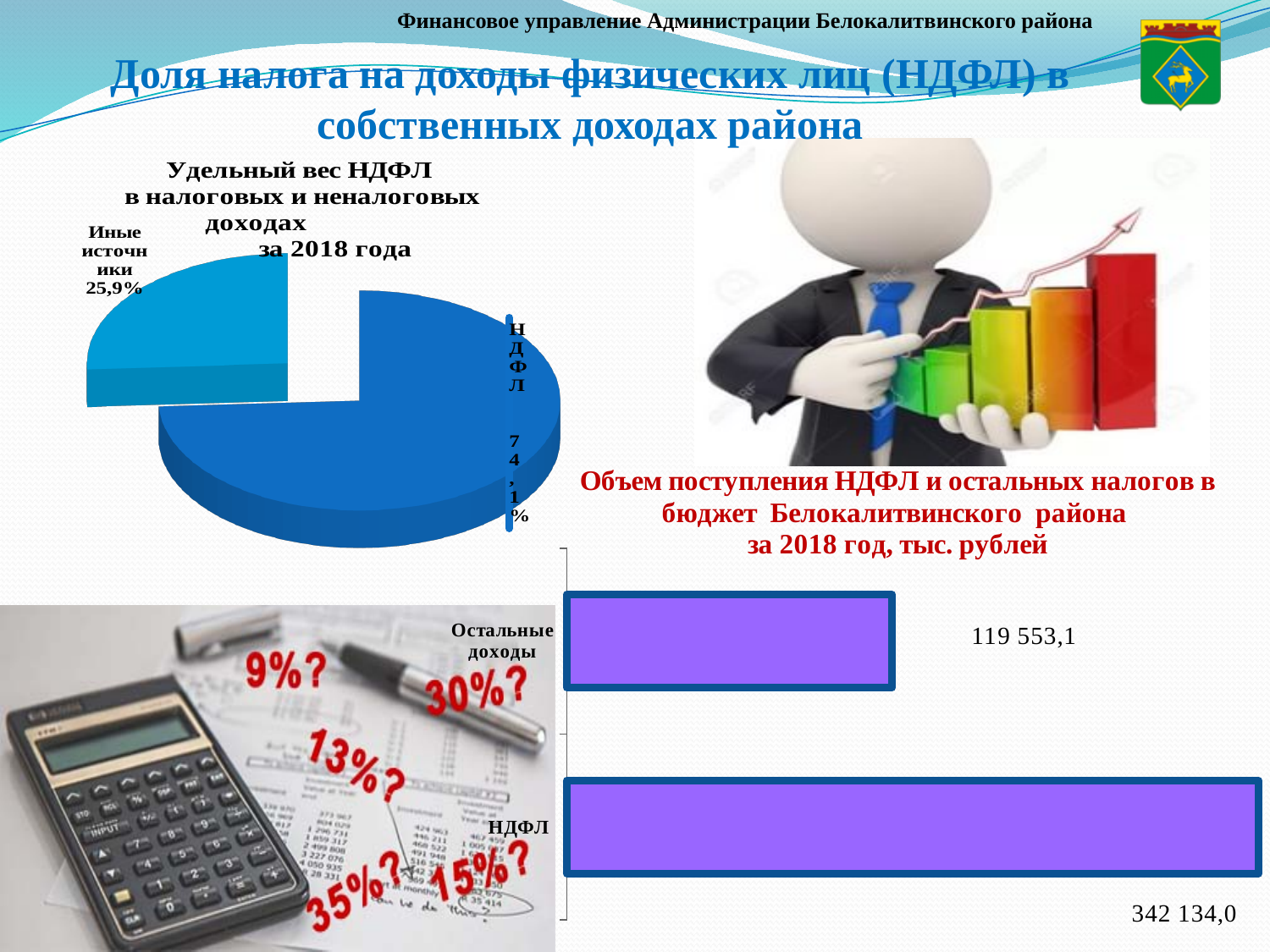
On the bar chart 'Объем поступления НДФЛ и остальных налогов в бюджет Белокалитвинского района за 2018 год, тыс. рублей', what is the value for 'Остальные доходы'? 119 553,1 On the pie chart 'Удельный вес НДФЛ в налоговых и неналоговых доходах за 2018 года', what is the difference in percentage points between the НДФЛ slice and the 'Иные источники' slice? 48,2 On the bar chart 'Объем поступления НДФЛ и остальных налогов в бюджет Белокалитвинского района за 2018 год, тыс. рублей', what is the value for НДФЛ? 342 134,0 On the bar chart 'Объем поступления НДФЛ и остальных налогов в бюджет Белокалитвинского района за 2018 год, тыс. рублей', what is the difference between the НДФЛ value and the 'Остальные доходы' value? 222 580,9 On the bar chart 'Объем поступления НДФЛ и остальных налогов в бюджет Белокалитвинского района за 2018 год, тыс. рублей', which category has the lowest value? Остальные доходы What kind of chart is 'Объем поступления НДФЛ и остальных налогов в бюджет Белокалитвинского района за 2018 год, тыс. рублей'? Bar chart What kind of chart is 'Удельный вес НДФЛ в налоговых и неналоговых доходах за 2018 года'? Pie chart On the pie chart 'Удельный вес НДФЛ в налоговых и неналоговых доходах за 2018 года', what share does НДФЛ have? 74,1% On the pie chart 'Удельный вес НДФЛ в налоговых и неналоговых доходах за 2018 года', which slice is the largest? НДФЛ On the pie chart 'Удельный вес НДФЛ в налоговых и неналоговых доходах за 2018 года', how many slices are there? 2 On the pie chart 'Удельный вес НДФЛ в налоговых и неналоговых доходах за 2018 года', what share do 'Иные источники' have? 25,9% On the bar chart 'Объем поступления НДФЛ и остальных налогов в бюджет Белокалитвинского района за 2018 год, тыс. рублей', which is larger: НДФЛ or 'Остальные доходы'? НДФЛ